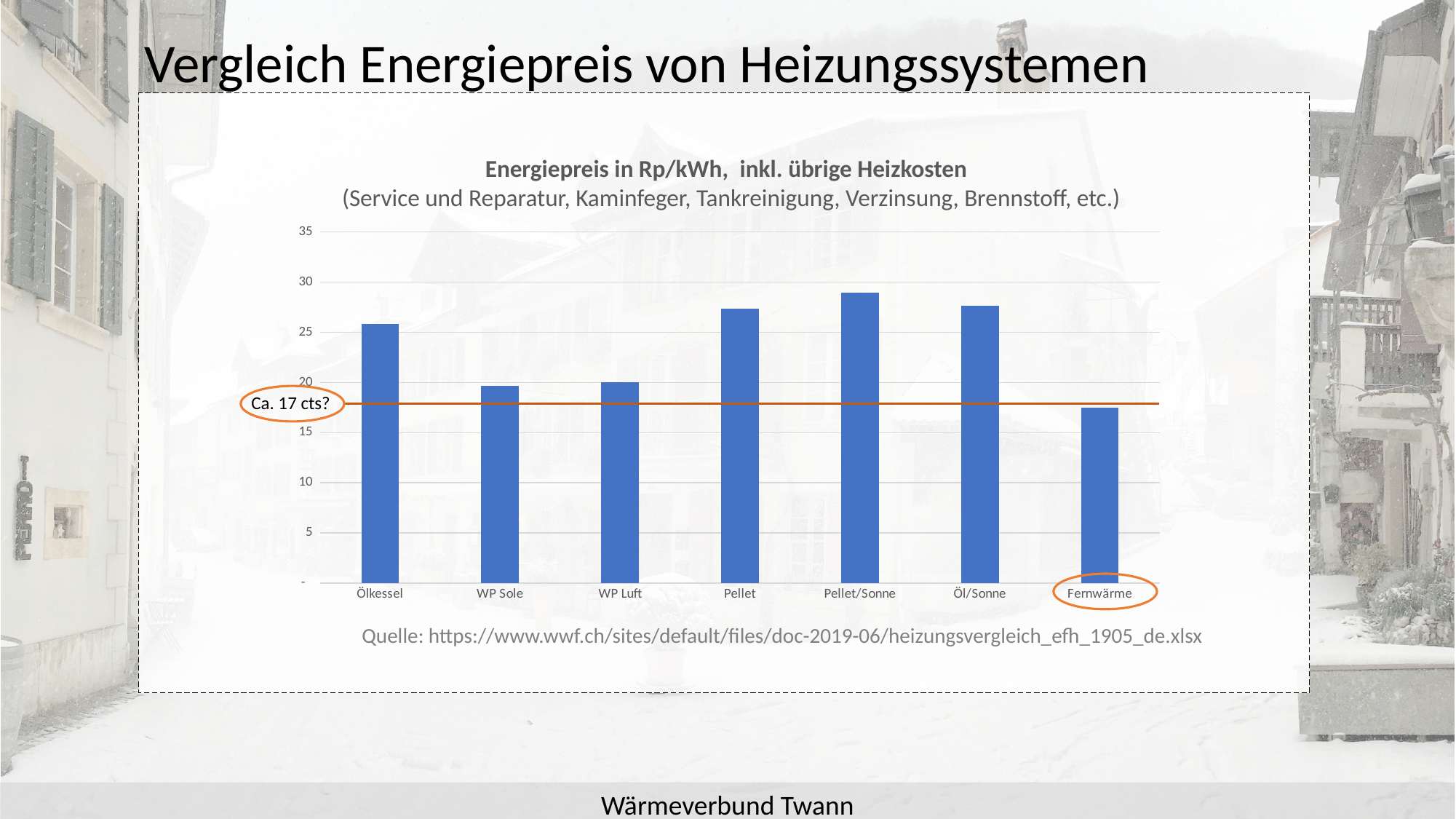
How many heating systems (categories) are shown on the x axis? 7 Is the value for Ölkessel greater or less than 20? greater Is the value for Pellet/Sonne greater or less than 30? less Which heating system has the highest energy price? Pellet/Sonne Is the value for Öl/Sonne greater or less than 25? greater What kind of chart is shown on the slide? bar chart What value does the annotation next to the horizontal orange line suggest? Ca. 17 cts? Which heating system has the lowest energy price? Fernwärme Which has a higher energy price, Ölkessel or WP Sole? Ölkessel Which has a higher energy price, Pellet or WP Luft? Pellet